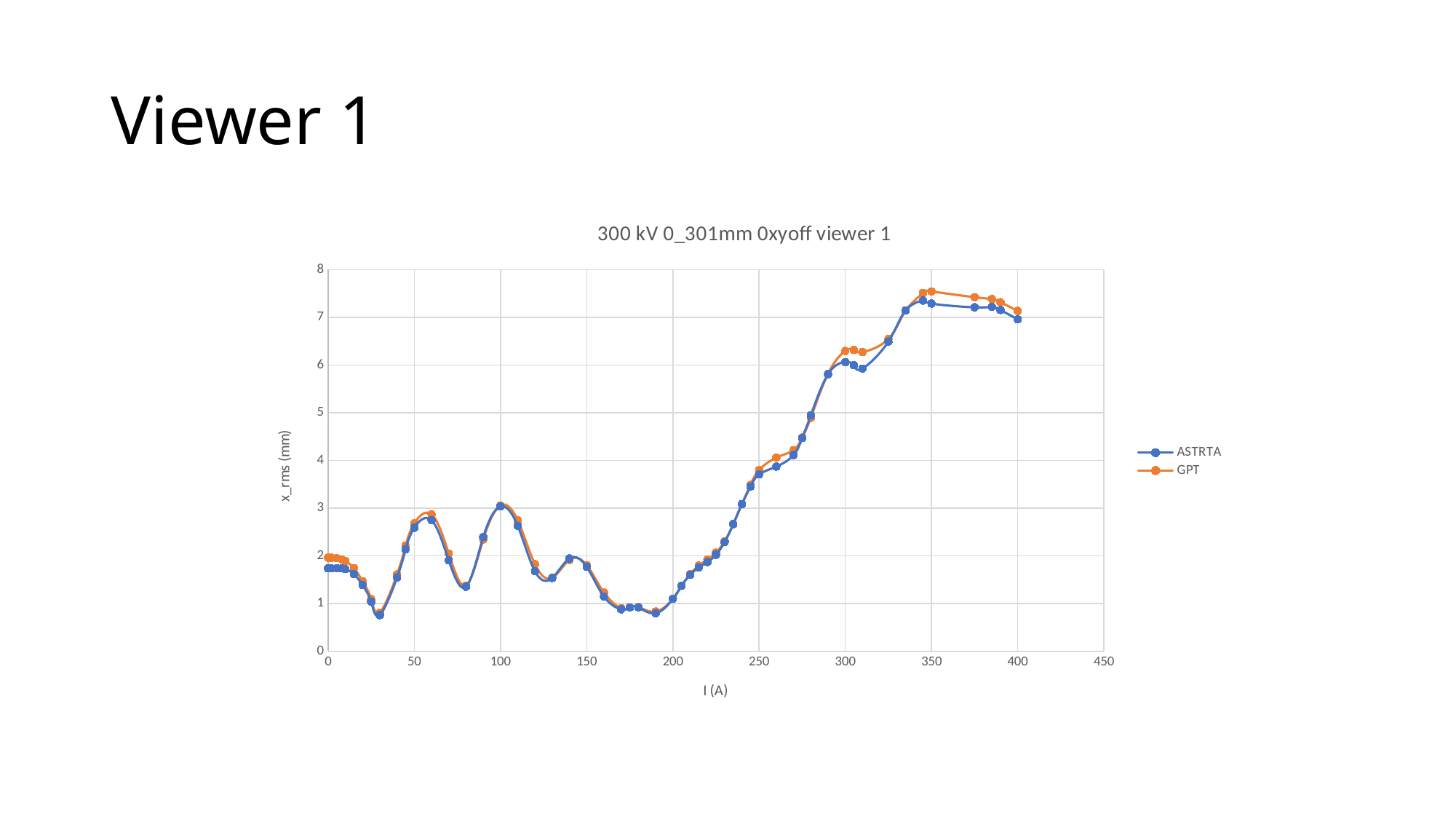
Is the ASTRTA value at 300 A greater or less than 5? greater What is the title of the chart? 300 kV 0_301mm 0xyoff viewer 1 Between 200 A and 350 A, do the plotted values generally rise or fall? rise Is the GPT value at 30 A greater or less than 1? less Is the GPT value at 250 A greater or less than 3? greater At 350 A, which series has the higher value, ASTRTA or GPT? GPT What kind of chart is shown on the slide? line chart How many series does the legend list? 2 Which series reaches the highest value anywhere on the chart? GPT What are the two series named in the legend? ASTRTA and GPT